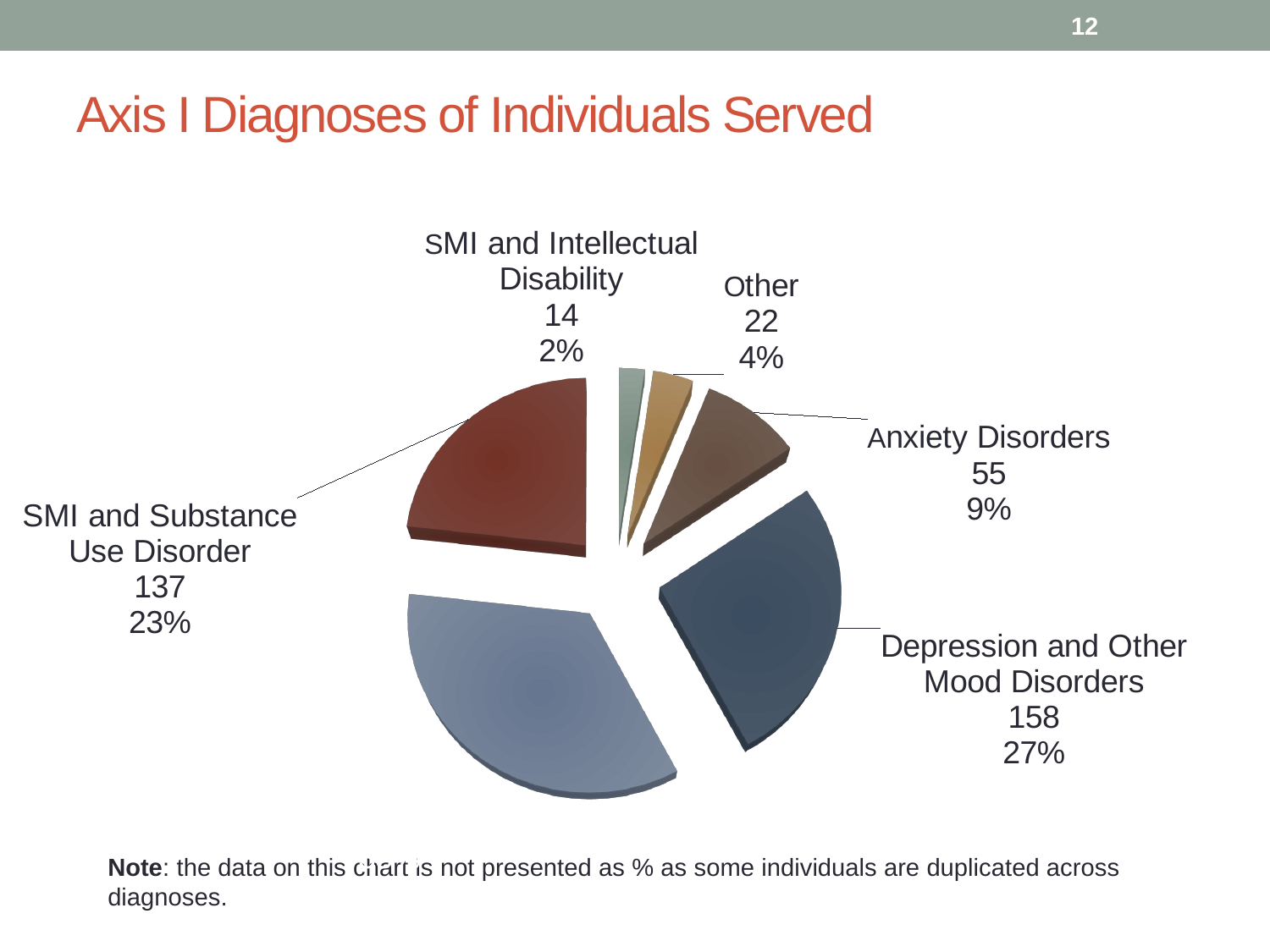
What is the difference between the values for Depression and Other Mood Disorders and SMI and Substance Use Disorder? 21 Which labeled category has the smallest value? SMI and Intellectual Disability What is the value for SMI and Substance Use Disorder? 137 What is the title of the chart? Axis I Diagnoses of Individuals Served What share of the pie does Anxiety Disorders represent? 9% What is the difference between the values for Anxiety Disorders and Other? 33 What share of the pie does SMI and Substance Use Disorder represent? 23% What is the value for Depression and Other Mood Disorders? 158 What is the value for Anxiety Disorders? 55 What is the value for Other? 22 Which is larger, the value for Anxiety Disorders or the value for Other? Anxiety Disorders What kind of chart is shown on the slide? Pie chart